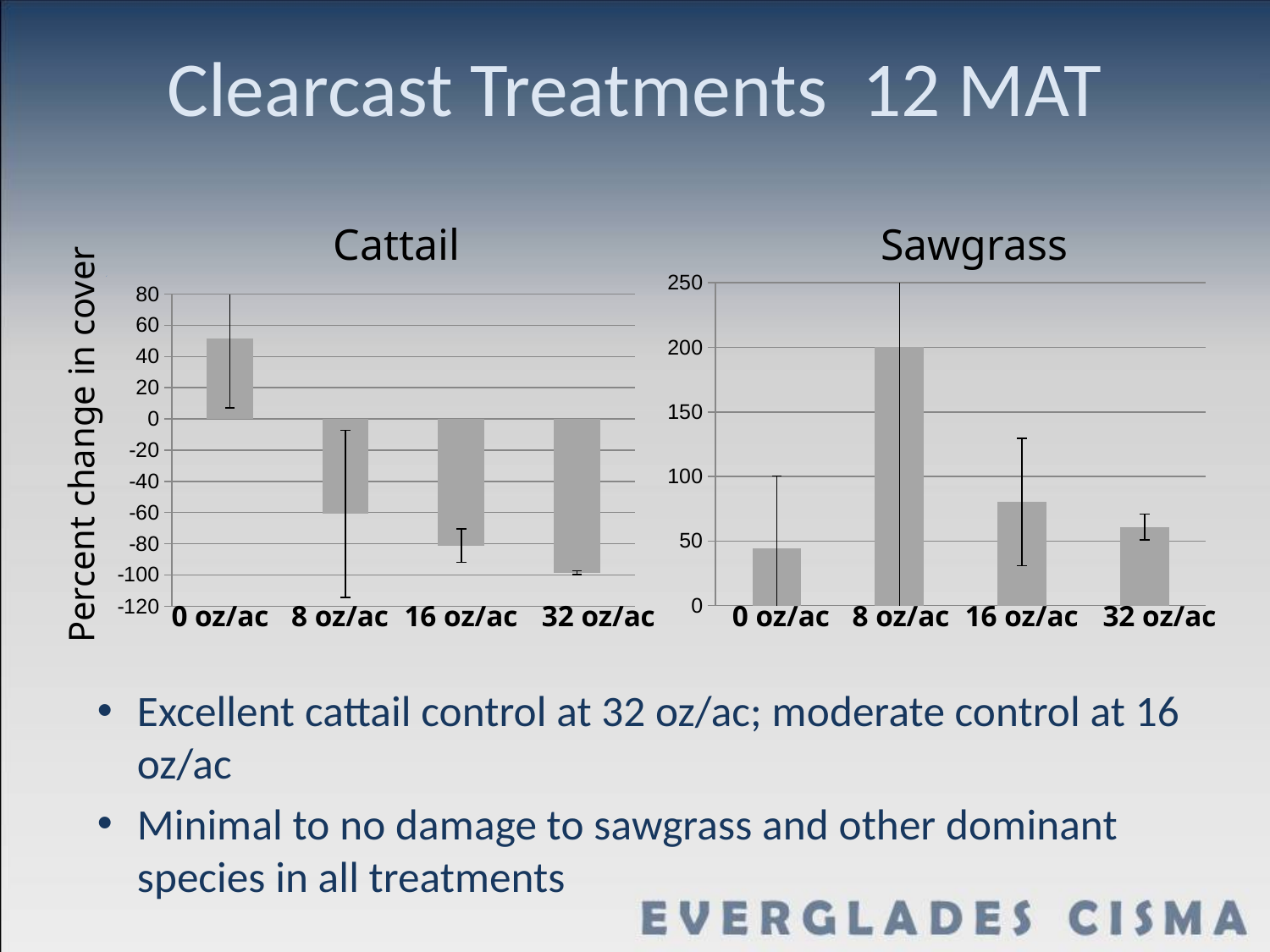
On the Cattail chart, is the value for 0 oz/ac greater or less than 40? greater On the Sawgrass chart, which treatment has the lowest value? 0 oz/ac How many treatment categories are shown on the Cattail chart? 4 How many treatment categories are shown on the Sawgrass chart? 4 On the Sawgrass chart, is the value for 16 oz/ac greater or less than 100? less On the Cattail chart, which treatment has the highest percent change in cover? 0 oz/ac On the Sawgrass chart, which treatment has the highest value? 8 oz/ac What kind of chart is the Cattail chart? bar chart On the Cattail chart, which treatment has the lowest percent change in cover? 32 oz/ac On the Cattail chart, is the value for 32 oz/ac greater or less than -80? less What is the label on the vertical axis of the Cattail chart? Percent change in cover On the Sawgrass chart, which is larger, the value for 16 oz/ac or the value for 32 oz/ac? 16 oz/ac